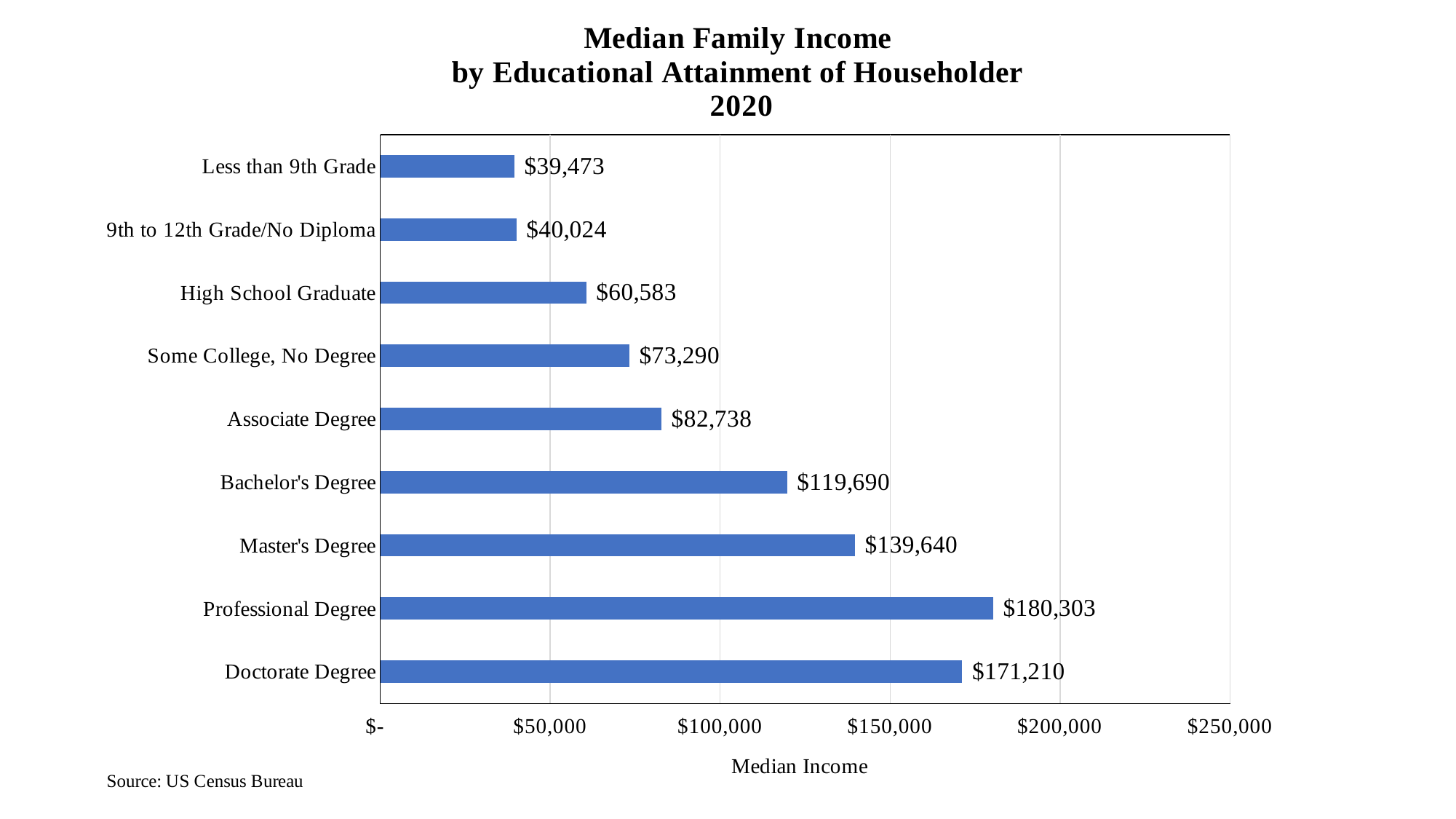
Which educational attainment category has the lowest median family income? Less than 9th Grade What kind of chart is shown on the slide? Bar chart What is the median family income for householders with a Doctorate Degree? $171,210 What is the difference in median family income between Master's Degree and Bachelor's Degree householders? $19,950 What is the median family income for householders with a High School Graduate education? $60,583 What is the source cited for the chart's data? US Census Bureau Which has a higher median family income: Doctorate Degree or Professional Degree? Professional Degree What is the median family income for householders with a Bachelor's Degree? $119,690 How many educational attainment categories are shown in the chart? 9 Which educational attainment category has the highest median family income? Professional Degree Is the median family income for Associate Degree householders greater or less than $100,000? less How much higher is the median family income for a Professional Degree than for a Doctorate Degree? $9,093